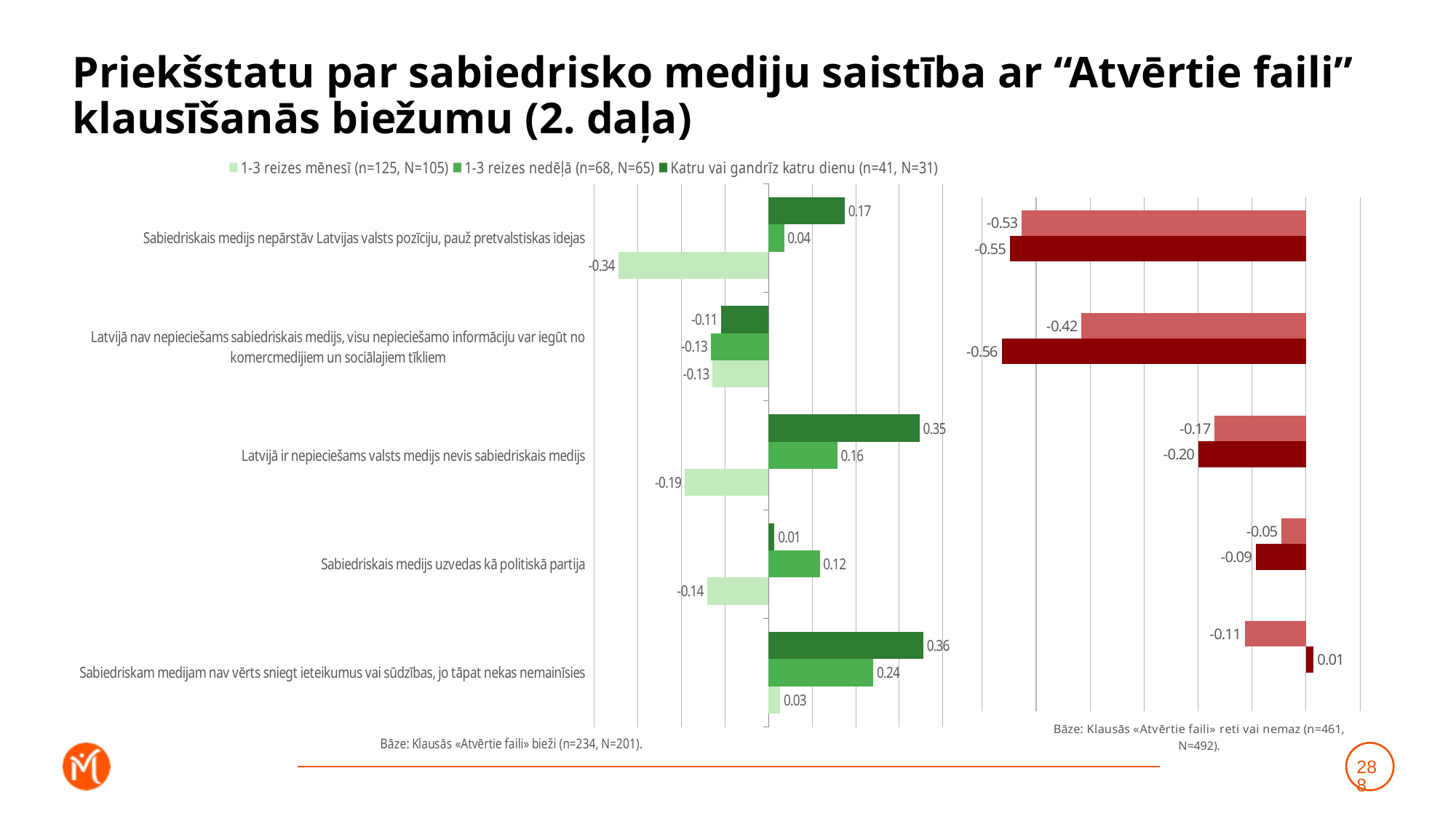
How many statements (categories) are shown on the left chart? 5 On the left chart, what is the value for '1-3 reizes mēnesī' for the statement 'Sabiedriskais medijs nepārstāv Latvijas valsts pozīciju, pauž pretvalstiskas idejas'? -0.34 On the right chart, what is the value of the darker red bar for 'Latvijā nav nepieciešams sabiedriskais medijs, visu nepieciešamo informāciju var iegūt no komercmedijiem un sociālajiem tīkliem'? -0.56 On the left chart, what is the difference between the 'Katru vai gandrīz katru dienu' value and the '1-3 reizes nedēļā' value for 'Latvijā ir nepieciešams valsts medijs nevis sabiedriskais medijs'? 0.19 On the left chart, what is the value for '1-3 reizes nedēļā' for the statement 'Sabiedriskam medijam nav vērts sniegt ieteikumus vai sūdzības, jo tāpat nekas nemainīsies'? 0.24 What type of chart is the left chart? Bar chart On the right chart, what is the value of the lighter red bar for 'Sabiedriskais medijs uzvedas kā politiskā partija'? -0.05 On the left chart, which statement has the lowest value for the '1-3 reizes mēnesī' series? Sabiedriskais medijs nepārstāv Latvijas valsts pozīciju, pauž pretvalstiskas idejas How many series does the legend of the left chart list? 3 On the left chart, for 'Sabiedriskais medijs uzvedas kā politiskā partija', which is larger: the '1-3 reizes nedēļā' value or the 'Katru vai gandrīz katru dienu' value? 1-3 reizes nedēļā On the left chart, what is the value for 'Katru vai gandrīz katru dienu' for the statement 'Latvijā ir nepieciešams valsts medijs nevis sabiedriskais medijs'? 0.35 On the left chart, which statement has the highest value for the 'Katru vai gandrīz katru dienu' series? Sabiedriskam medijam nav vērts sniegt ieteikumus vai sūdzības, jo tāpat nekas nemainīsies